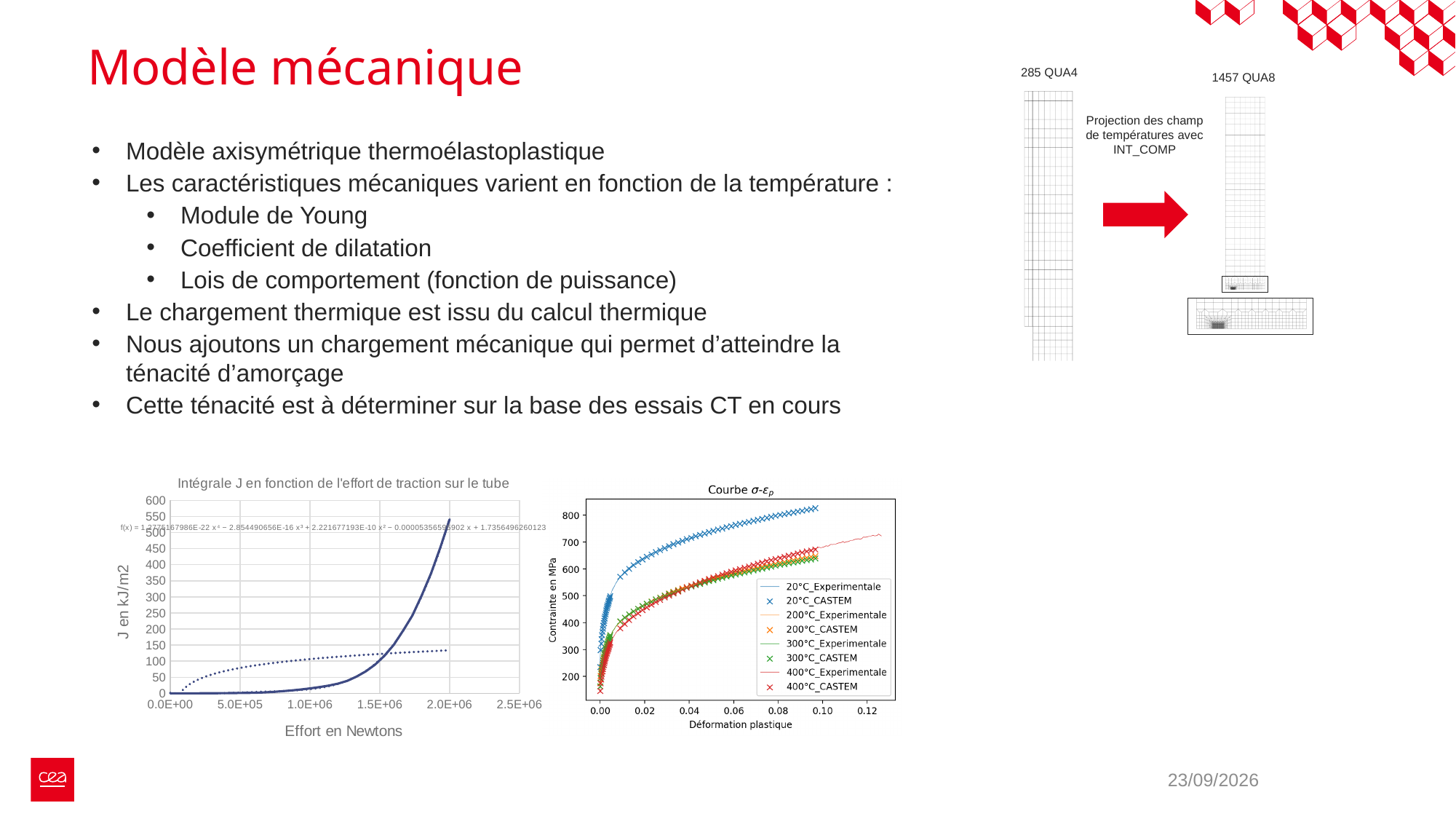
How many series does the legend of the right chart 'Courbe σ-εp' list? 8 In the right chart 'Courbe σ-εp', at a plastic strain of 0.08, which is larger: the 20°C_CASTEM value or the 300°C_CASTEM value? 20°C_CASTEM In the right chart 'Courbe σ-εp', is the maximum value of the 20°C_CASTEM series greater or less than 800? greater In the right chart 'Courbe σ-εp', which temperature's curves reach the highest stress values? 20°C What kind of chart is the left chart titled 'Intégrale J en fonction de l'effort de traction sur le tube'? line chart In the left chart, does the solid curve rise or fall as the effort increases along the x axis? rise In the right chart 'Courbe σ-εp', do the stress values rise or fall as plastic strain increases along the x axis? rise In the left chart, what is the label of the y axis? J en kJ/m2 In the left chart, what is the highest tick value shown on the y axis? 600 In the left chart, is the value of the dotted curve at 2.0E+06 N greater or less than 200? less In the left chart, is the value of the solid curve at 2.0E+06 N greater or less than 500? greater In the left chart, what is the label of the x axis? Effort en Newtons